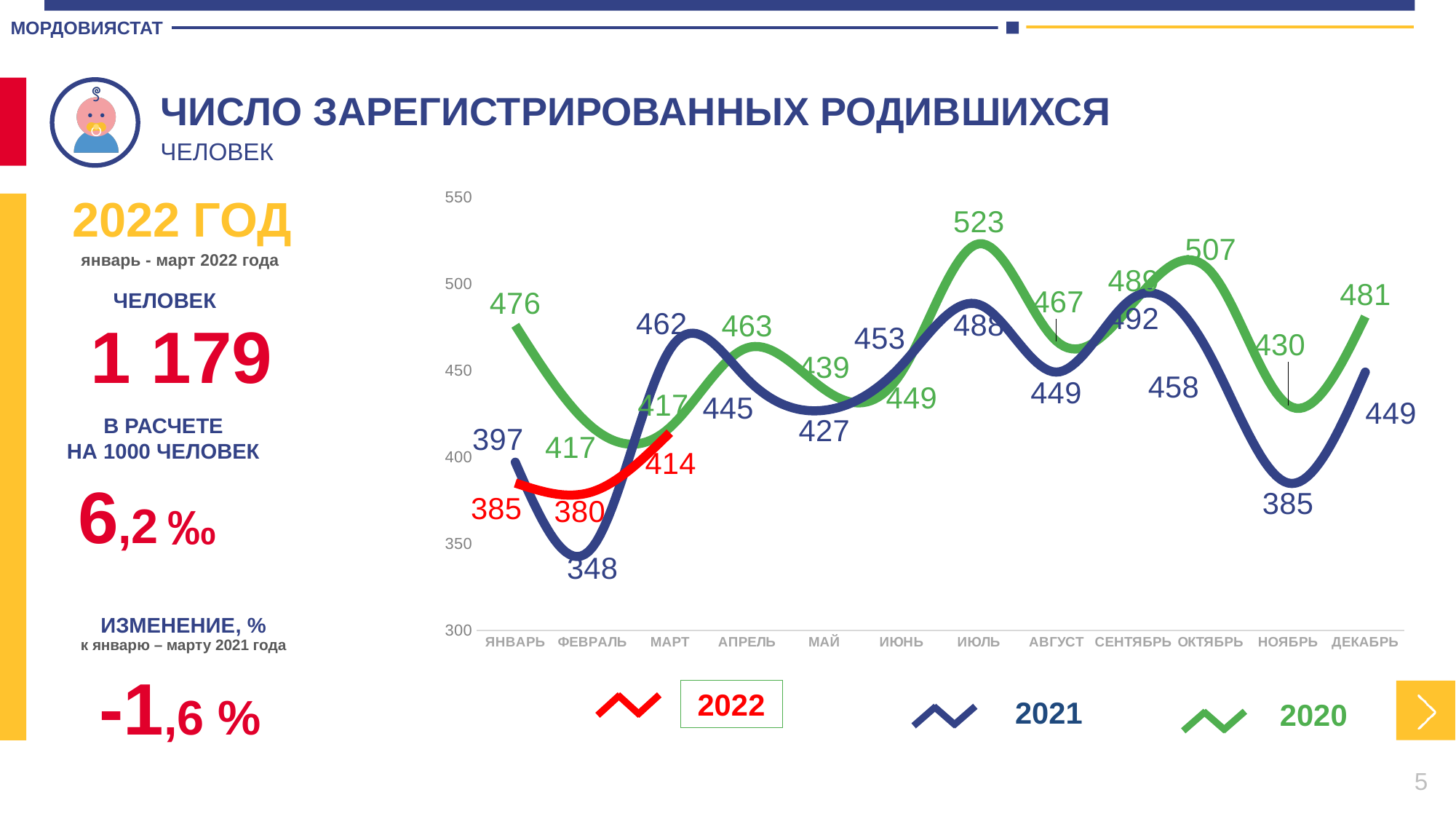
Which series has the larger value for ЯНВАРЬ, 2020 or 2021? 2020 What is the value for ИЮЛЬ in the 2020 series? 523 Does the 2022 series rise or fall from ФЕВРАЛЬ to МАРТ? rises How many months are shown along the x axis of the chart? 12 What kind of chart is shown on the slide? line chart What is the difference between the 2021 values for МАРТ and ФЕВРАЛЬ? 114 What is the value for ФЕВРАЛЬ in the 2021 series? 348 How many series does the chart legend list? 3 What is the value for МАРТ in the 2022 series? 414 In which month does the 2021 series reach its lowest value? ФЕВРАЛЬ In which month does the 2020 series reach its highest value? ИЮЛЬ What colour is the line for the 2022 series? red